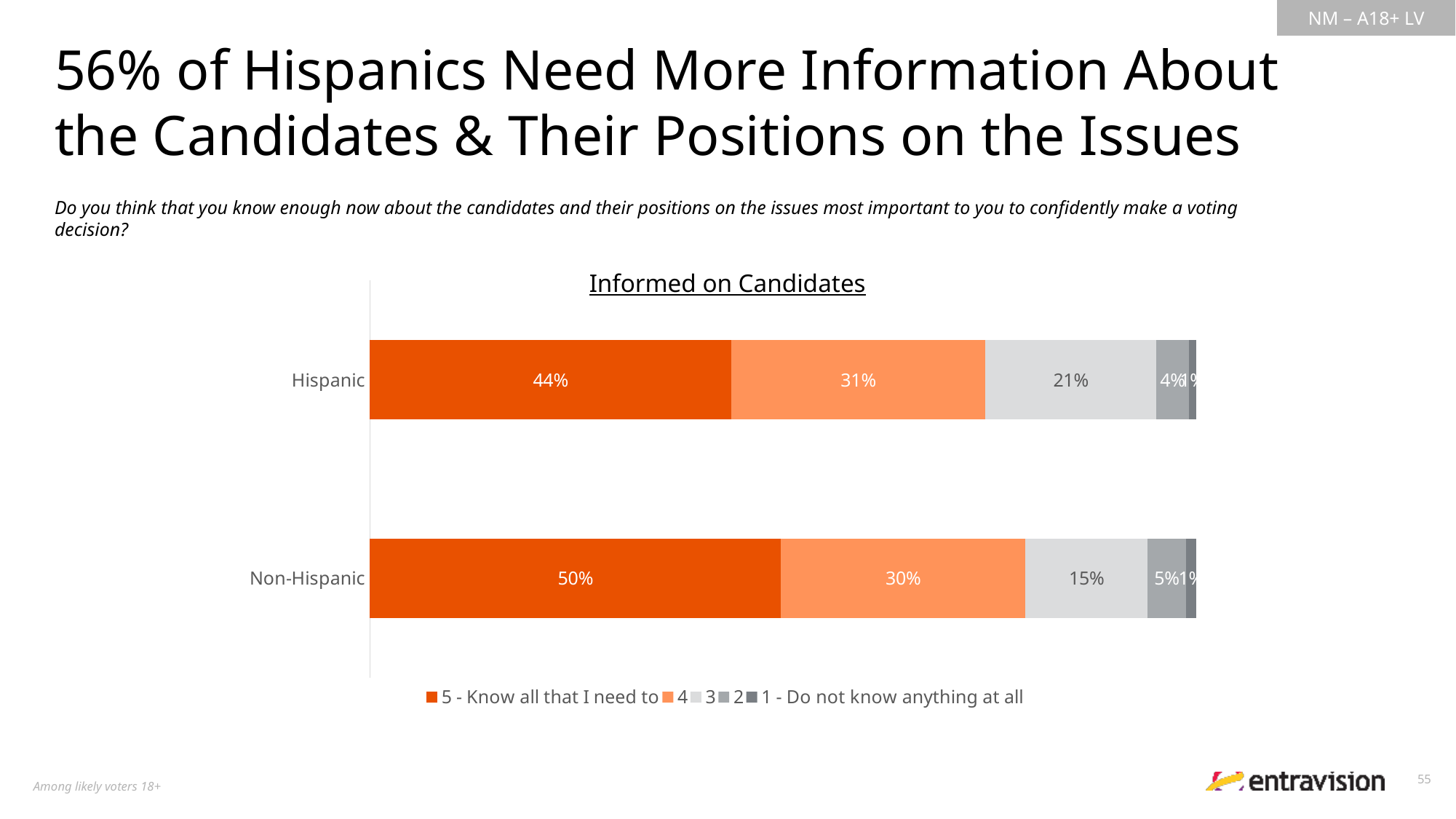
What percentage of Hispanic respondents said '5 - Know all that I need to'? 44% What is the value of the '3' segment for Hispanic respondents? 21% Which group has the larger share answering '5 - Know all that I need to', Hispanic or Non-Hispanic? Non-Hispanic What is the title of the chart? Informed on Candidates How many categories (bars) are shown in the chart? 2 What is the value of the '4' segment for Non-Hispanic respondents? 30% Which segment is the largest in the Hispanic bar? 5 - Know all that I need to What kind of chart is shown on the slide? Stacked bar chart How many series does the chart legend list? 5 What is the difference between the Non-Hispanic and Hispanic shares for '5 - Know all that I need to'? 6% What is the difference between the Hispanic and Non-Hispanic shares for the '3' rating? 6% What percentage of Non-Hispanic respondents said '5 - Know all that I need to'? 50%